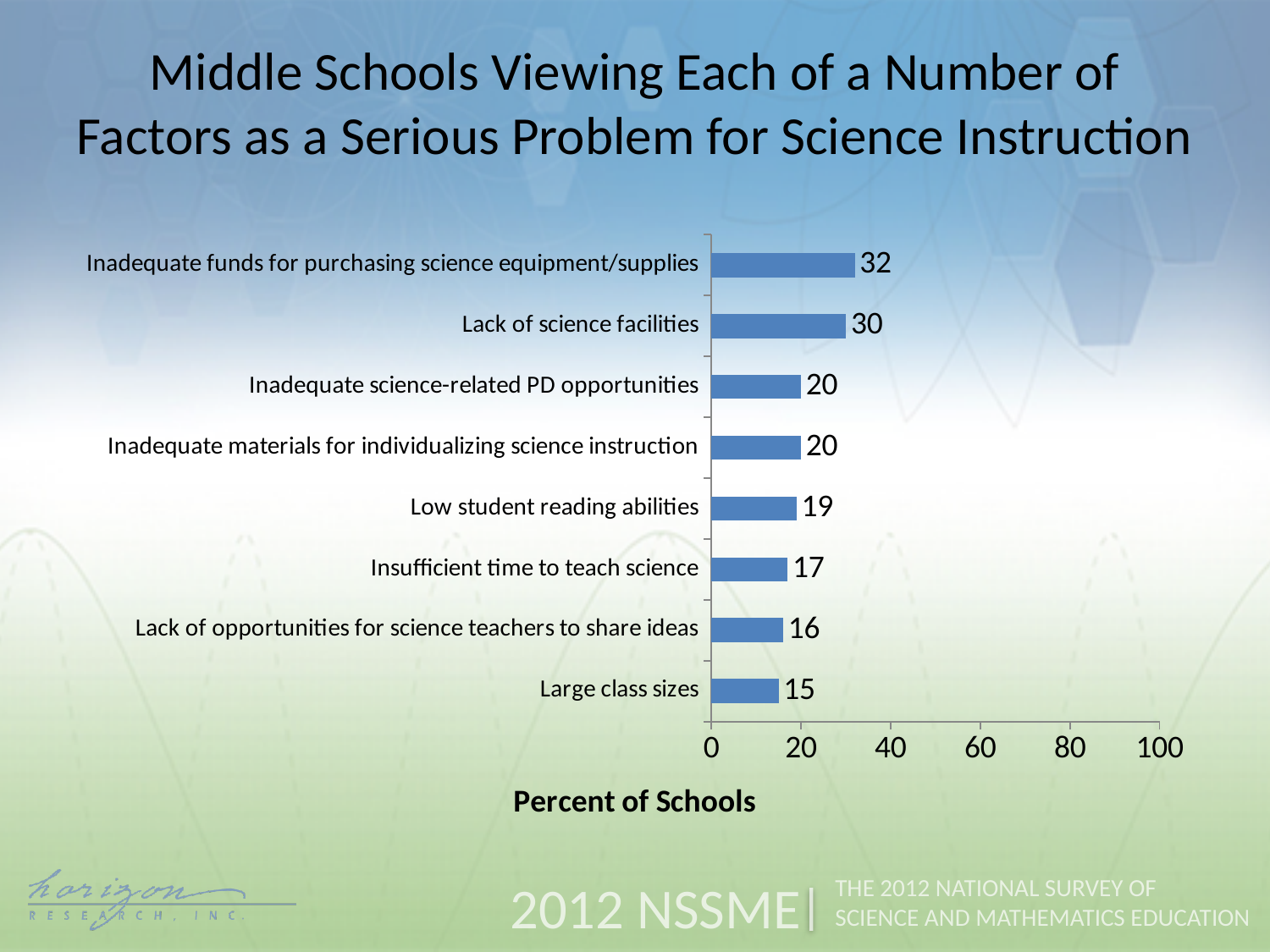
Is the value for Lack of science facilities greater or less than 20? greater What is the difference between the values for Inadequate funds for purchasing science equipment/supplies and Large class sizes? 17 What is the label of the horizontal axis? Percent of Schools Which factor has the lowest percent of schools viewing it as a serious problem? Large class sizes What kind of chart is shown on the slide? Bar chart Which factor has the highest percent of schools viewing it as a serious problem? Inadequate funds for purchasing science equipment/supplies What is the value for Low student reading abilities? 19 What is the value for Lack of science facilities? 30 What is the value for Large class sizes? 15 What percent of middle schools view inadequate funds for purchasing science equipment/supplies as a serious problem? 32 How many factors are shown in the chart? 8 Which is larger: the value for Insufficient time to teach science or the value for Lack of opportunities for science teachers to share ideas? Insufficient time to teach science